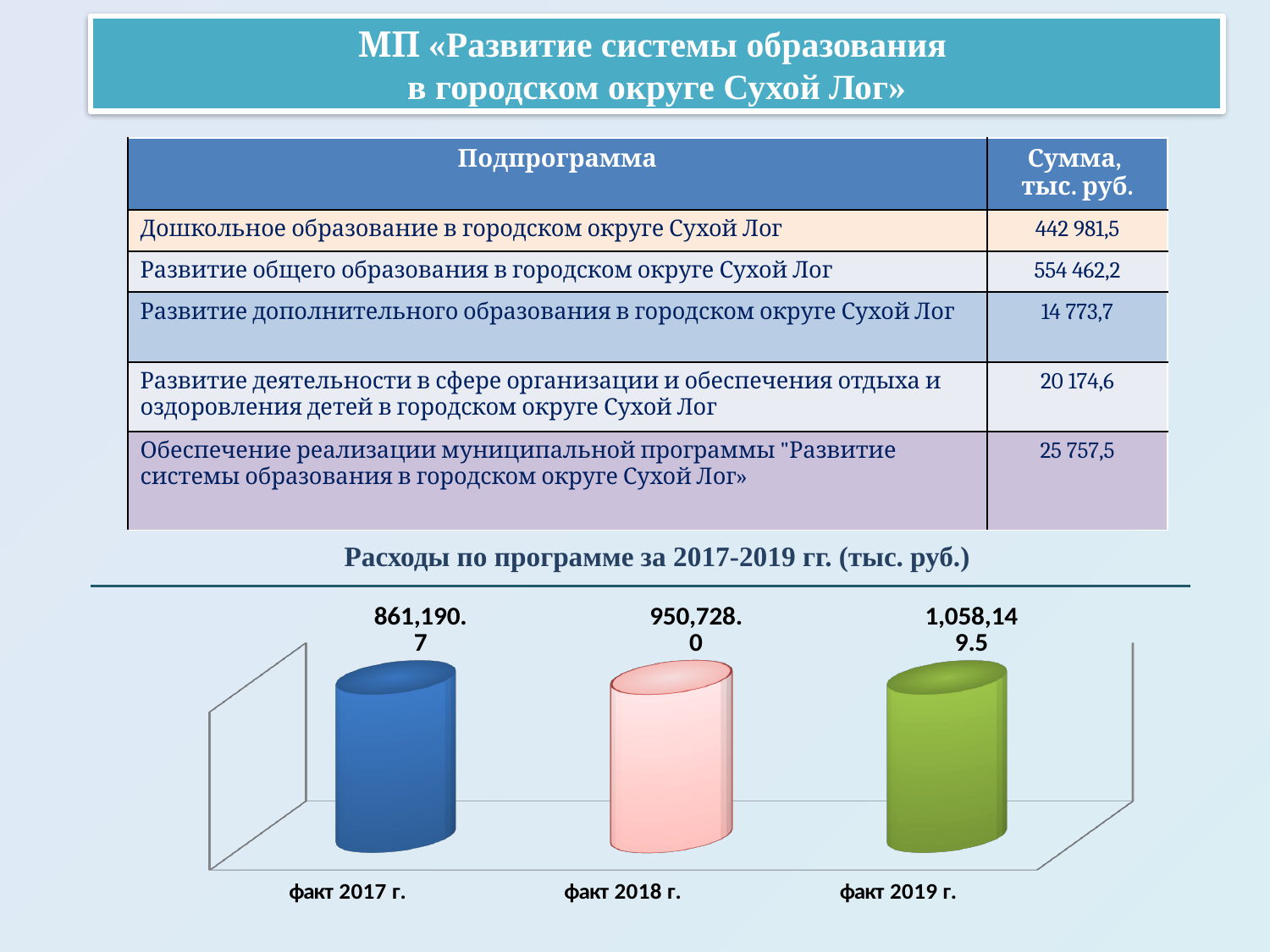
What is the title of the chart at the bottom of the slide? Расходы по программе за 2017-2019 гг. (тыс. руб.) What is the value for факт 2019 г. in the chart 'Расходы по программе за 2017-2019 гг. (тыс. руб.)'? 1,058,149.5 What is the value for факт 2017 г. in the chart 'Расходы по программе за 2017-2019 гг. (тыс. руб.)'? 861,190.7 What is the difference between the values for факт 2018 г. and факт 2017 г. in the chart 'Расходы по программе за 2017-2019 гг. (тыс. руб.)'? 89,537.3 What is the value for факт 2018 г. in the chart 'Расходы по программе за 2017-2019 гг. (тыс. руб.)'? 950,728.0 Do the values rise or fall from факт 2017 г. to факт 2019 г. in the chart 'Расходы по программе за 2017-2019 гг. (тыс. руб.)'? rise Which category has the lowest value in the chart 'Расходы по программе за 2017-2019 гг. (тыс. руб.)'? факт 2017 г. How many categories are shown in the chart 'Расходы по программе за 2017-2019 гг. (тыс. руб.)'? 3 What is the difference between the values for факт 2019 г. and факт 2018 г. in the chart 'Расходы по программе за 2017-2019 гг. (тыс. руб.)'? 107,421.5 Which category has the highest value in the chart 'Расходы по программе за 2017-2019 гг. (тыс. руб.)'? факт 2019 г. What kind of chart is 'Расходы по программе за 2017-2019 гг. (тыс. руб.)'? bar chart Which is larger in the chart 'Расходы по программе за 2017-2019 гг. (тыс. руб.)': the value for факт 2017 г. or факт 2019 г.? факт 2019 г.